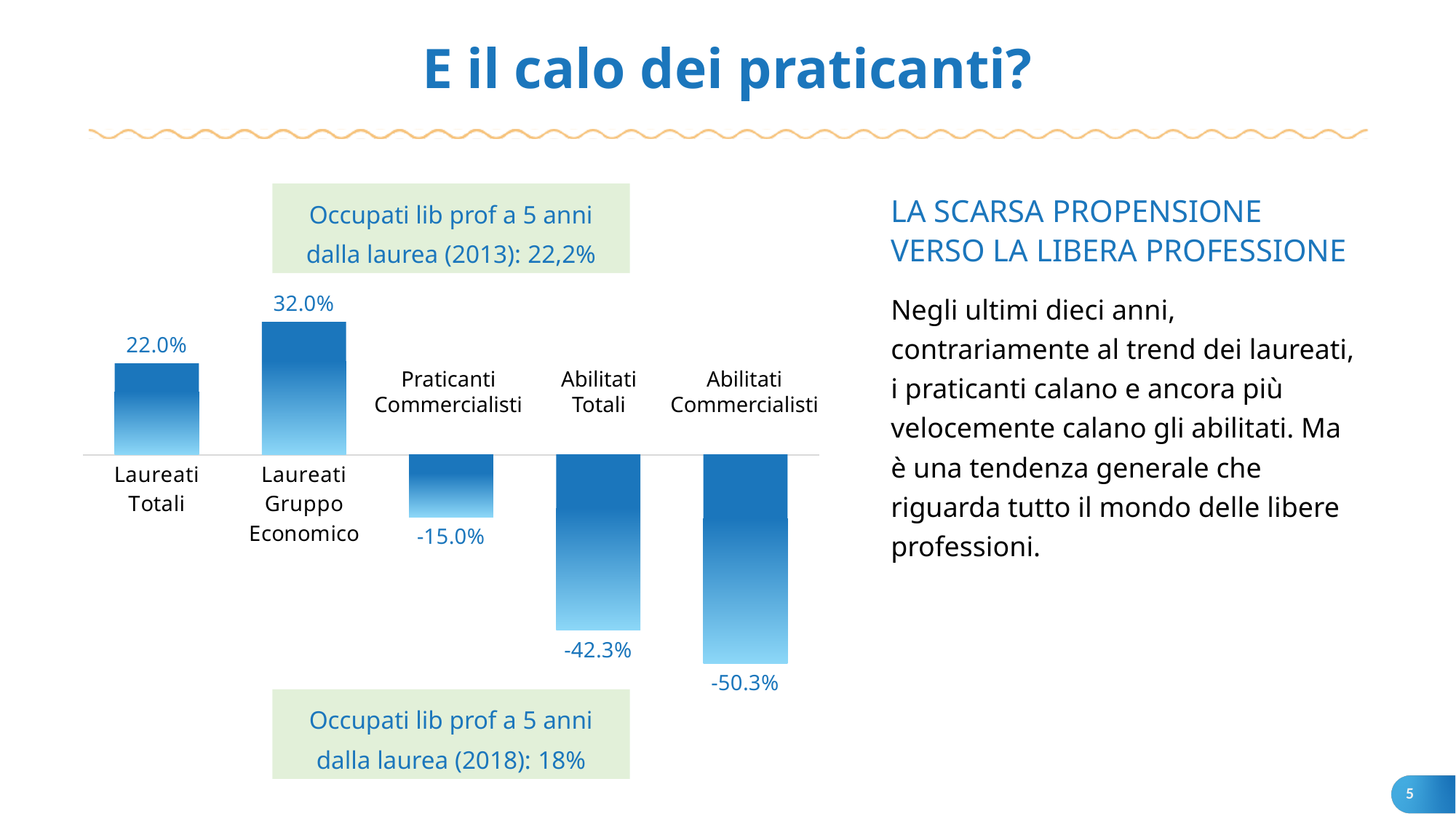
What kind of chart is shown on the slide? Bar chart How many categories in the chart have negative values? 3 How many categories are shown in the chart? 5 What is the difference between the values for Laureati Gruppo Economico and Laureati Totali? 10.0% Which is larger, the value for Abilitati Totali or the value for Praticanti Commercialisti? Praticanti Commercialisti What is the value shown for Abilitati Totali? -42.3% Which category has the highest value in the chart? Laureati Gruppo Economico What is the value shown for Laureati Totali? 22.0% What is the value shown for Laureati Gruppo Economico? 32.0% What is the value shown for Abilitati Commercialisti? -50.3% What is the value shown for Praticanti Commercialisti? -15.0% Which category has the lowest value in the chart? Abilitati Commercialisti